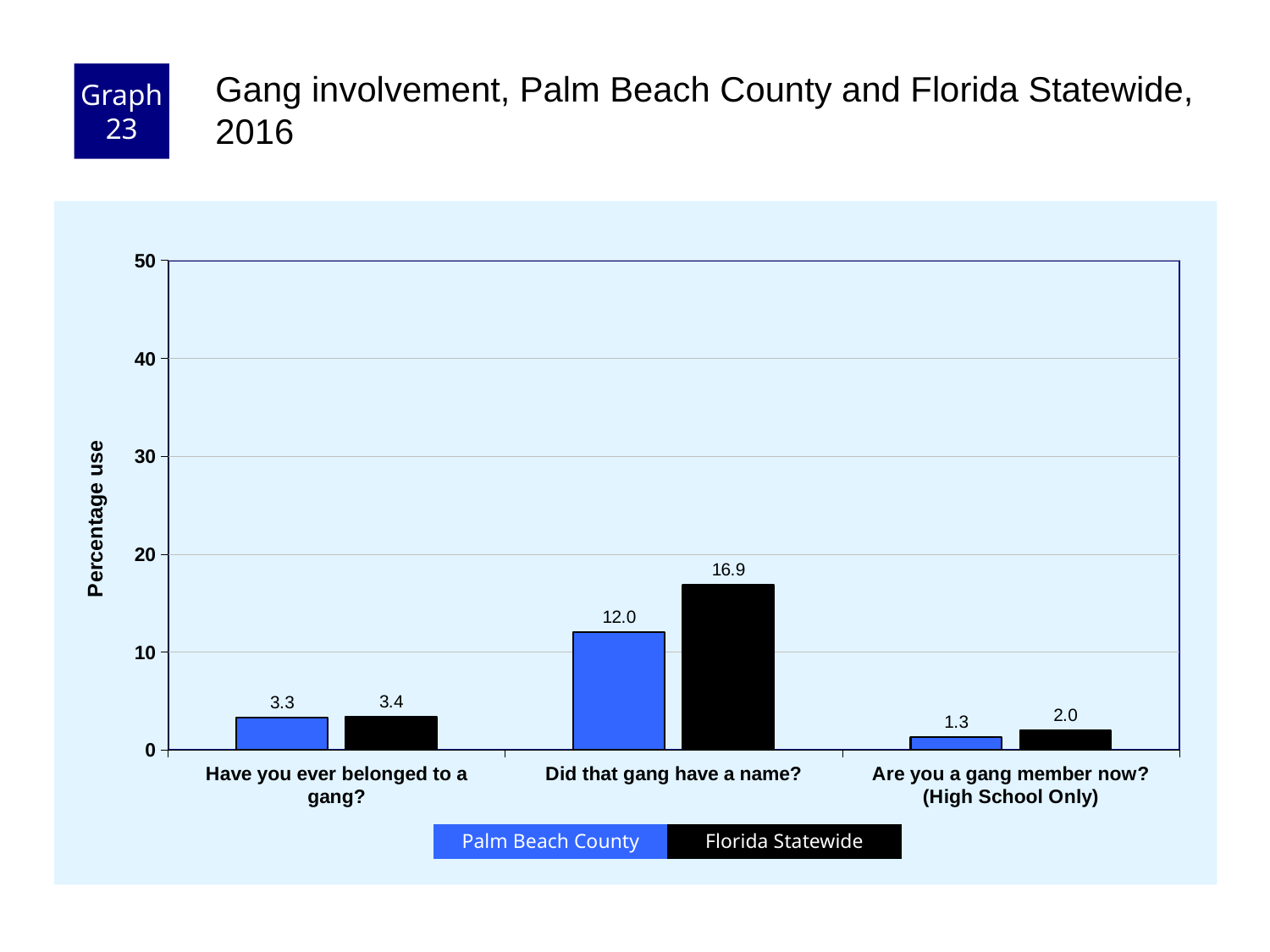
What is the Florida Statewide value for "Are you a gang member now? (High School Only)"? 2.0 How many series does the legend list? 2 Is the Florida Statewide value for "Did that gang have a name?" greater or less than 20? less Which question has the lowest Palm Beach County value? Are you a gang member now? (High School Only) Which question has the highest Florida Statewide value? Did that gang have a name? How many question categories are shown on the x axis? 3 What is the label of the y axis? Percentage use What is the difference between the Florida Statewide and Palm Beach County values for "Did that gang have a name?"? 4.9 What is the Palm Beach County value for "Did that gang have a name?"? 12.0 For "Are you a gang member now? (High School Only)", which series has the larger value, Palm Beach County or Florida Statewide? Florida Statewide What is the Florida Statewide value for "Have you ever belonged to a gang?"? 3.4 What kind of chart is shown on the slide? Bar chart